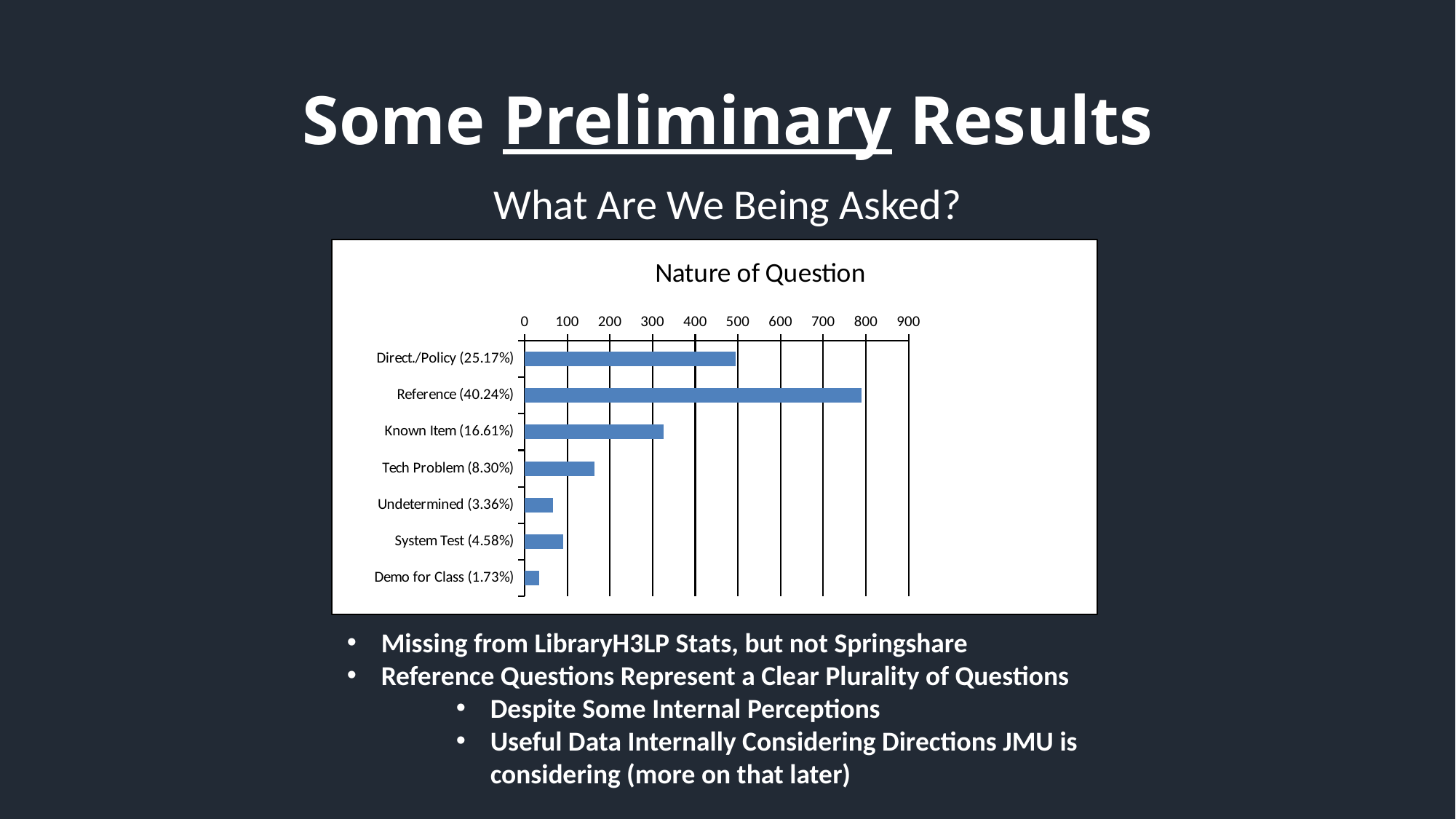
What kind of chart is shown on the slide? bar chart What is the title of the chart? Nature of Question What percentage is shown in the category label for Reference? 40.24% Is the value for Tech Problem greater or less than 100? greater What percentage is shown in the category label for Known Item? 16.61% Is the value for Direct./Policy greater or less than 400? greater Is the value for Undetermined greater or less than 100? less Which has the larger value, System Test or Undetermined? System Test Which category has the longest bar? Reference (40.24%) How many categories are plotted in the chart? 7 Which category has the shortest bar? Demo for Class (1.73%)